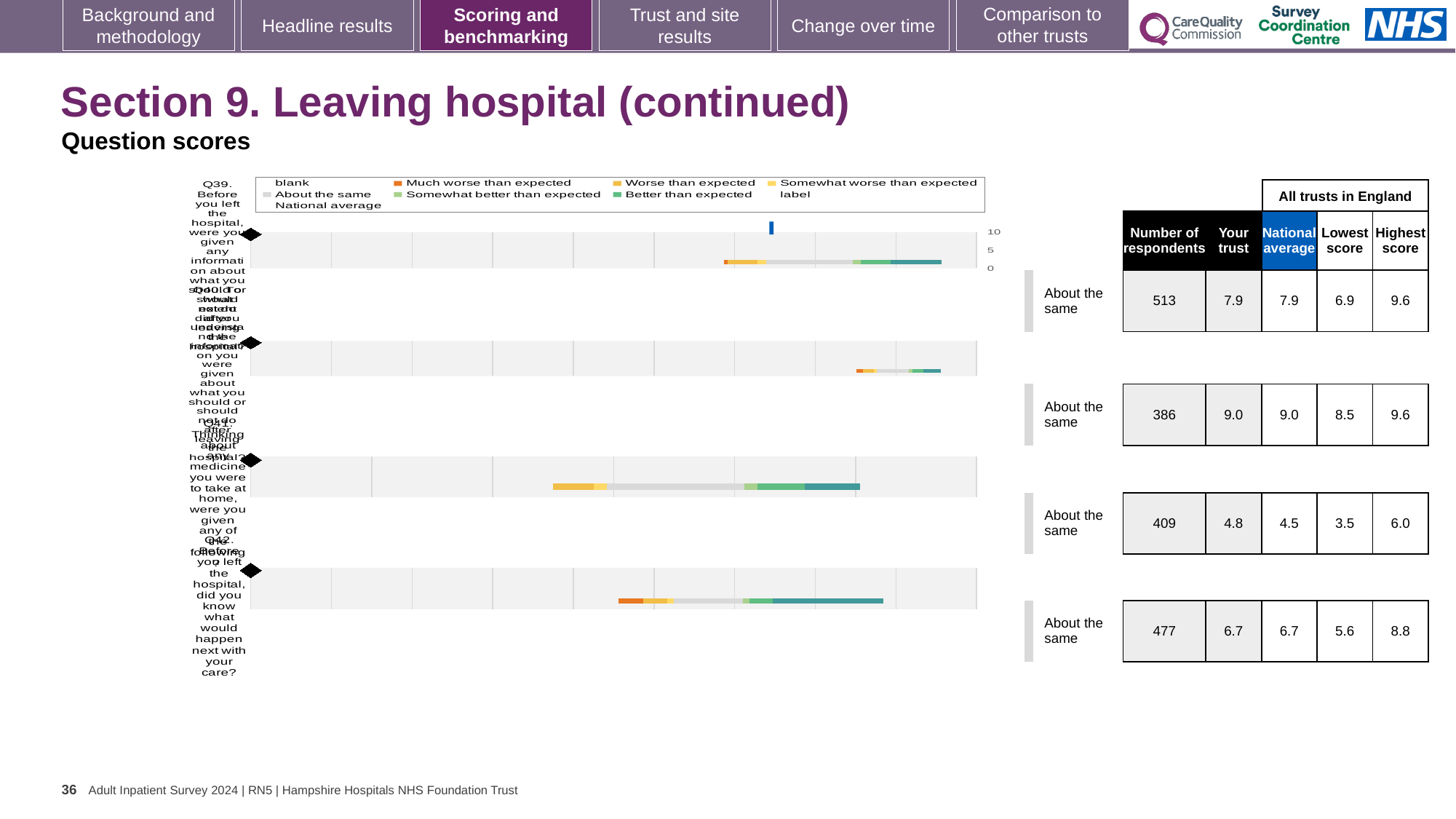
What kind of chart is used for the question scores on this slide? bar chart In the table beside the charts, what is the difference between the highest score and lowest score for the first question row (Q39)? 2.7 In the chart legend, what colour represents 'Much worse than expected'? orange In the table beside the charts, is the 'Your trust' score for the third row larger or smaller than its national average? larger In the table beside the charts, which question row has the lowest 'Your trust' score? the third row (4.8) In the table beside the charts, what is the highest score in England for the third question row? 6.0 In the chart legend, what colour represents 'Better than expected'? teal In the table beside the charts, what is the national average for the last question (Q42)? 6.7 What benchmark category is shown next to each of the four charts? About the same In the table beside the charts, what is the number of respondents for the second question row? 386 In the table beside the charts, what is the 'Your trust' score for the first question (Q39)? 7.9 How many separate question-score bar charts are shown on the slide? 4